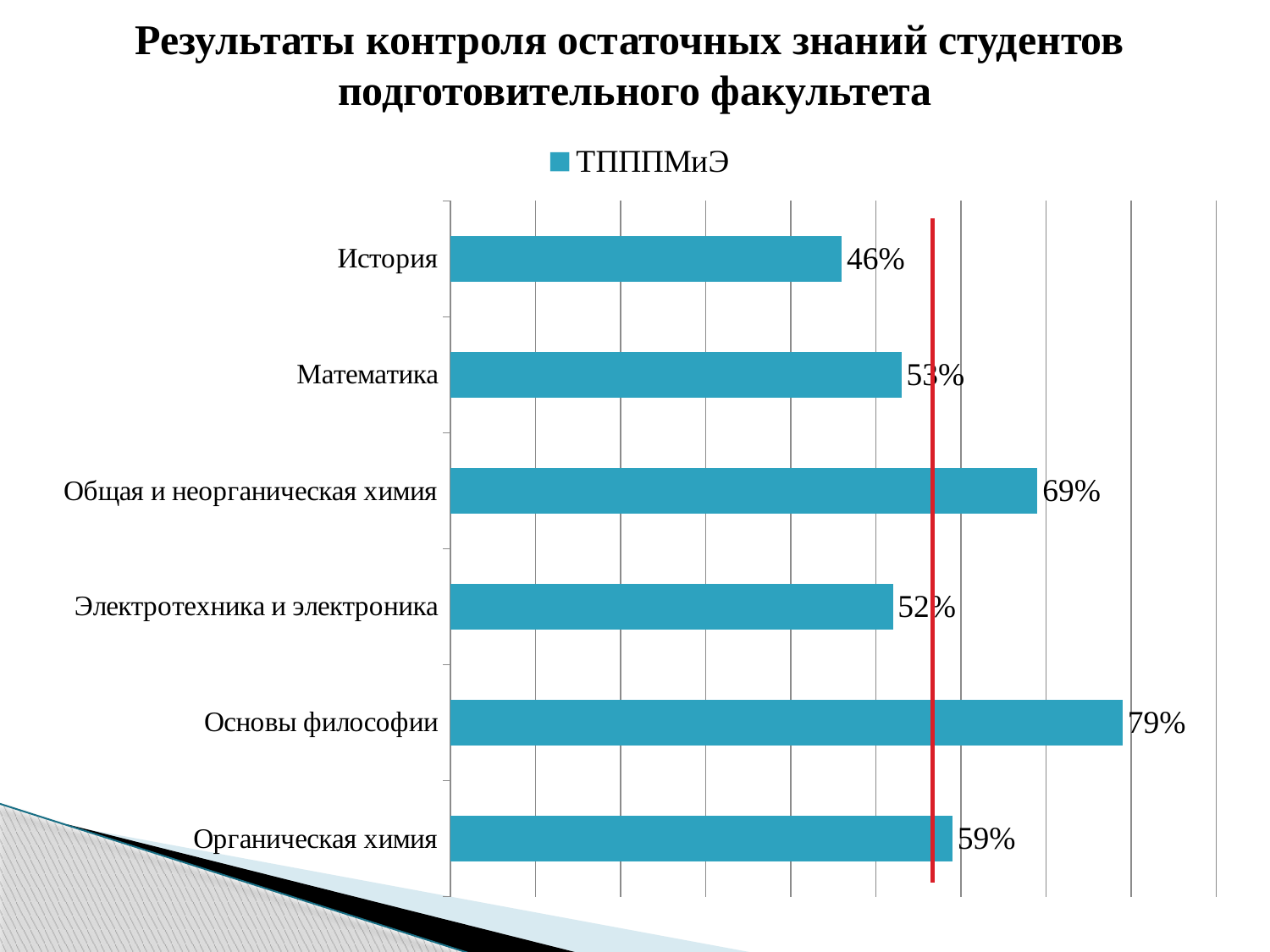
What kind of chart is shown on the slide? Bar chart How many series does the legend list? 1 What is the value for Общая и неорганическая химия? 69% Which category has the lowest value? История What is the value for Органическая химия? 59% What is the value for Основы философии? 79% What is the value for История? 46% What is the difference between the values for Общая и неорганическая химия and Органическая химия? 10% How many categories are shown in the chart? 6 What is the difference between the values for Основы философии and История? 33% Which category has the highest value? Основы философии Which is larger, the value for Математика or the value for Органическая химия? Органическая химия